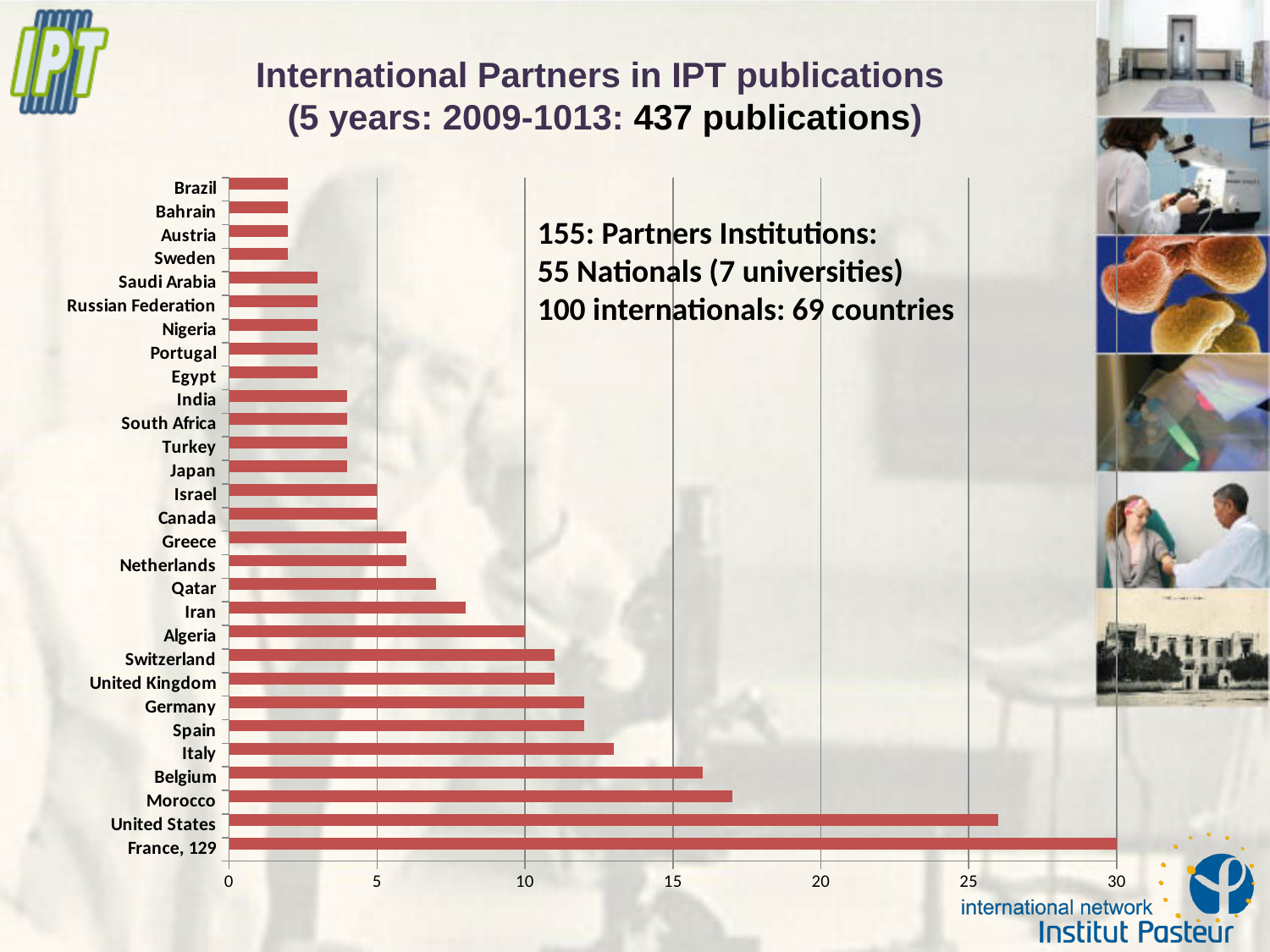
Which has a larger value, Belgium or Italy? Belgium Is the value for Italy greater or less than 10? greater Is the value for Morocco greater or less than 15? greater Which has a larger value, the United States or Morocco? United States Is the value for Iran greater or less than 10? less What kind of chart is shown on the slide? bar chart What value is printed for France on the chart? 129 How many countries are listed on the chart? 29 Which country has the highest value on the chart? France What is the title of the chart on the slide? International Partners in IPT publications (5 years: 2009-1013: 437 publications)